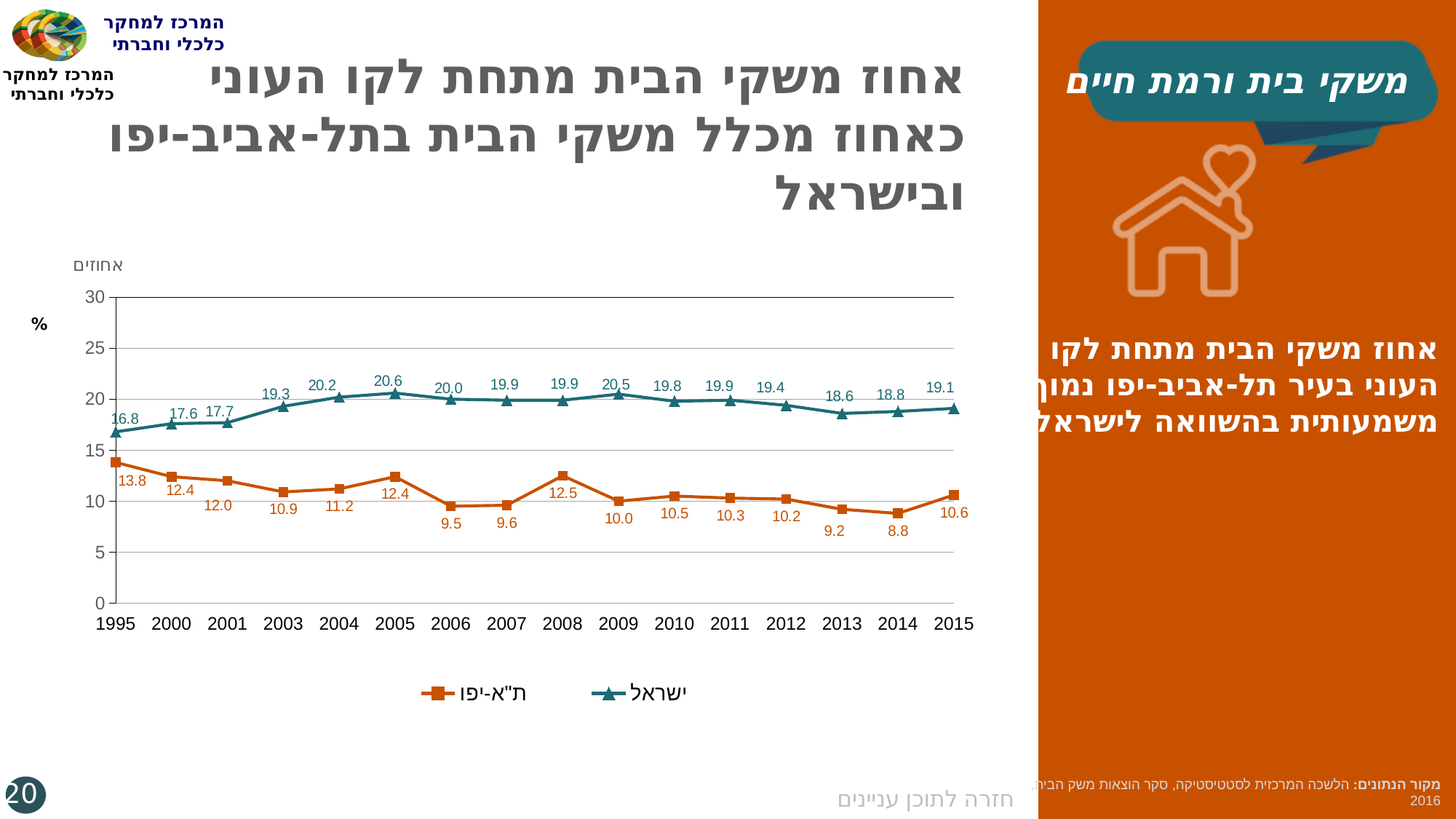
Is the value for ת"א-יפו in 2006 greater or less than 10? less What is the difference between the ישראל and ת"א-יפו values in 2015? 8.5 How many years are plotted along the x axis? 16 In which year is the ת"א-יפו series at its lowest? 2014 What is the value for ישראל in 2005? 20.6 Which series has the higher value in 2008, ישראל or ת"א-יפו? ישראל What type of chart is shown on the slide? line chart In which year is the ישראל series at its highest? 2005 What is the value for ת"א-יפו in 2014? 8.8 What is the unit label shown above the y axis? אחוזים What is the value for ת"א-יפו in 1995? 13.8 How many series does the legend list? 2